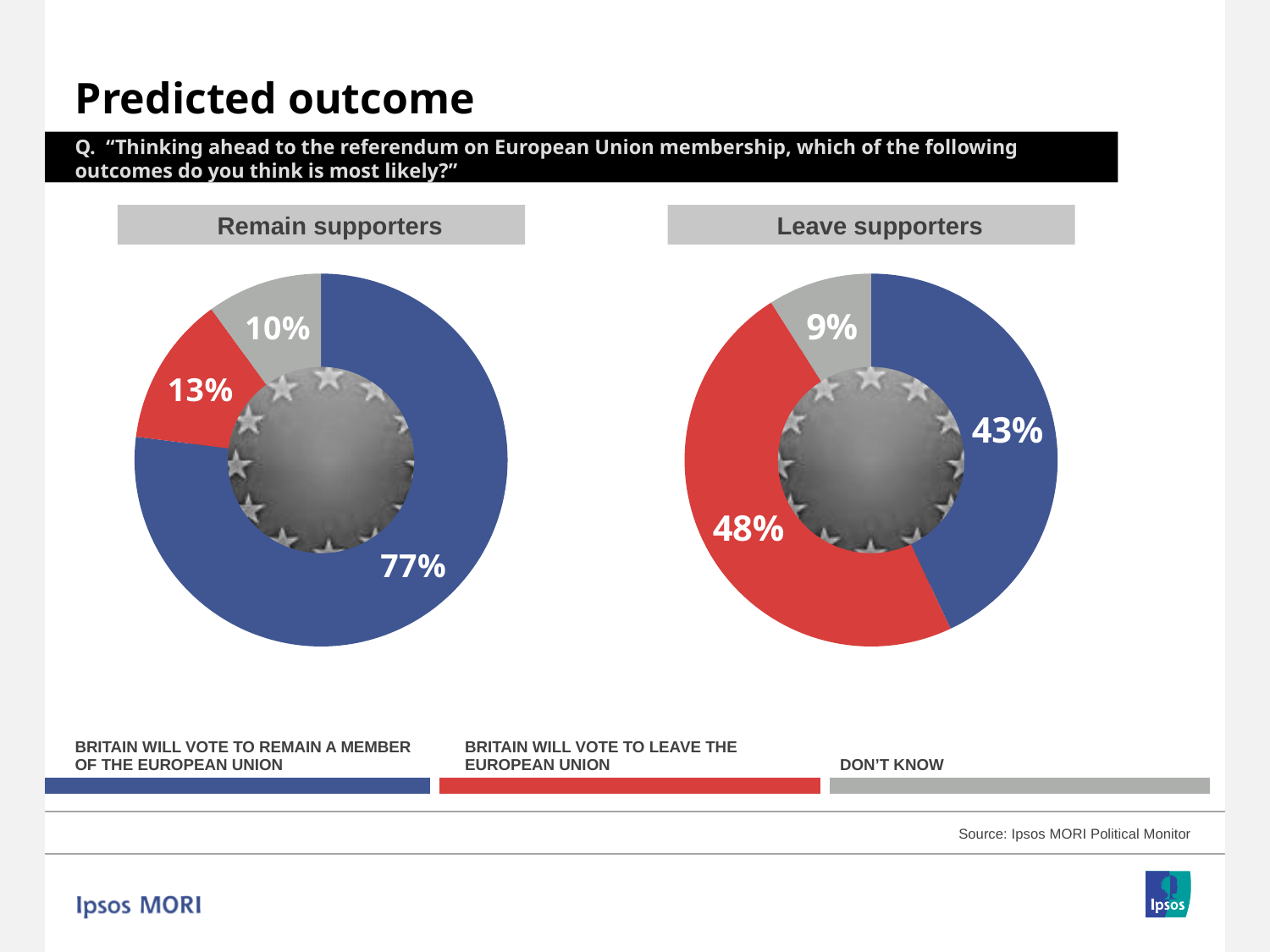
In the Remain supporters chart, what percentage think Britain will vote to remain a member of the European Union? 77% In the Leave supporters chart, which outcome has the smallest share? Don't know What kind of chart is used for the Remain supporters data? Doughnut chart In the Leave supporters chart, what percentage answered Don't know? 9% In the Leave supporters chart, what percentage think Britain will vote to leave the European Union? 48% How many categories does each chart show? 3 Which chart has the larger Don't know share, Remain supporters or Leave supporters? Remain supporters In the Remain supporters chart, what is the difference between the share expecting a remain vote and the share expecting a leave vote? 64% In the Remain supporters chart, what percentage think Britain will vote to leave the European Union? 13% In the Remain supporters chart, which outcome has the largest share? Britain will vote to remain a member of the European Union What colour represents Don't know in the charts? Grey In the Leave supporters chart, what is the difference between the share expecting a leave vote and the share expecting a remain vote? 5%